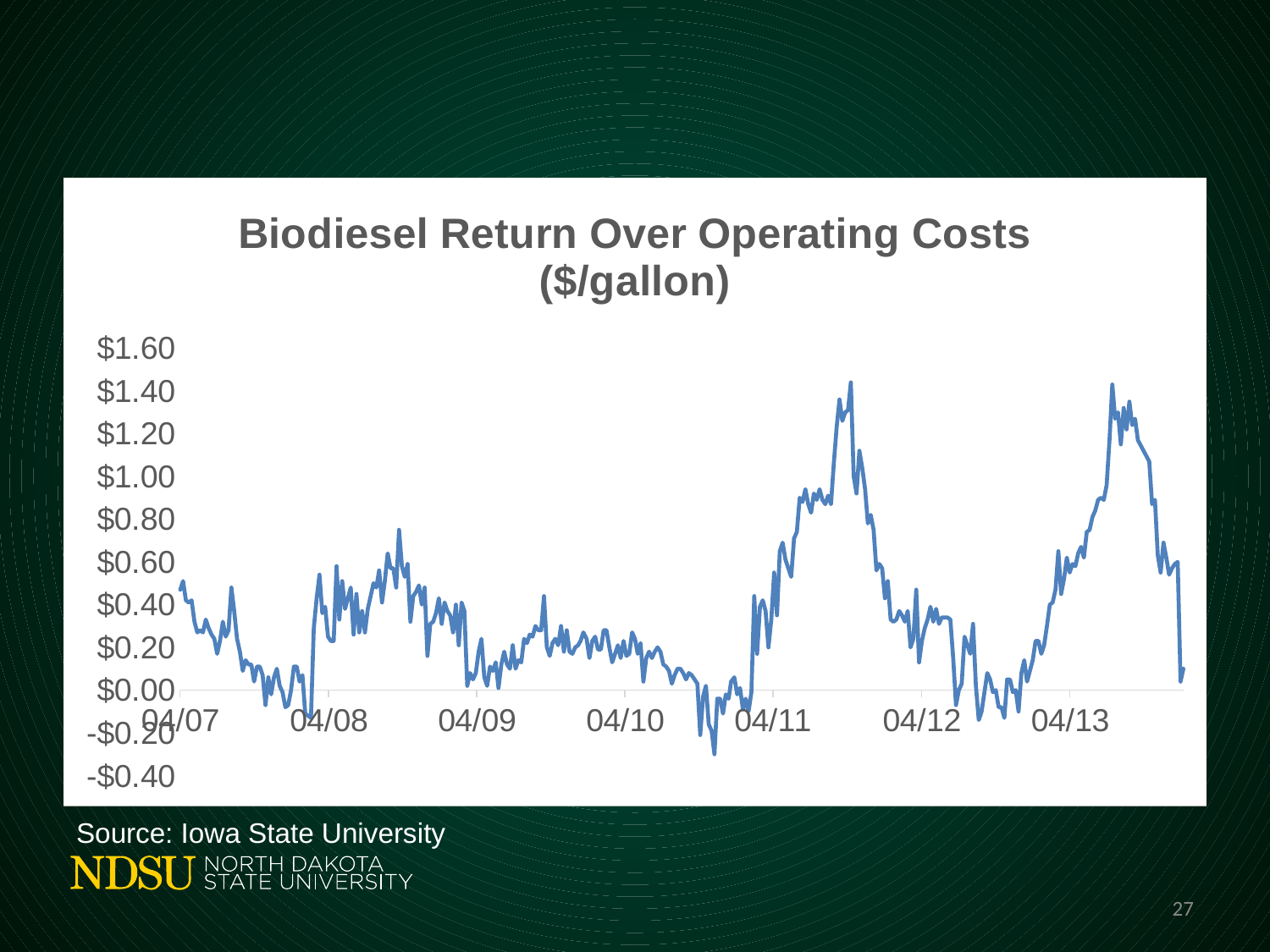
How many date labels are shown on the x axis of the chart? 7 Is the value at 04/07 greater or less than $0.80? less What is the title of the chart? Biodiesel Return Over Operating Costs ($/gallon) Is the value at 04/12 greater or less than $0.60? less Which is larger: the peak after 04/11 or the peak after 04/08? the peak after 04/11 What is the highest value labelled on the y axis? $1.60 Does the line rise or fall between 04/11 and its peak later that year? rise Is the value at 04/13 greater or less than $1.00? less Does the line rise or fall from its peak after 04/13 to the end of the series? fall What kind of chart is shown on the slide? line chart